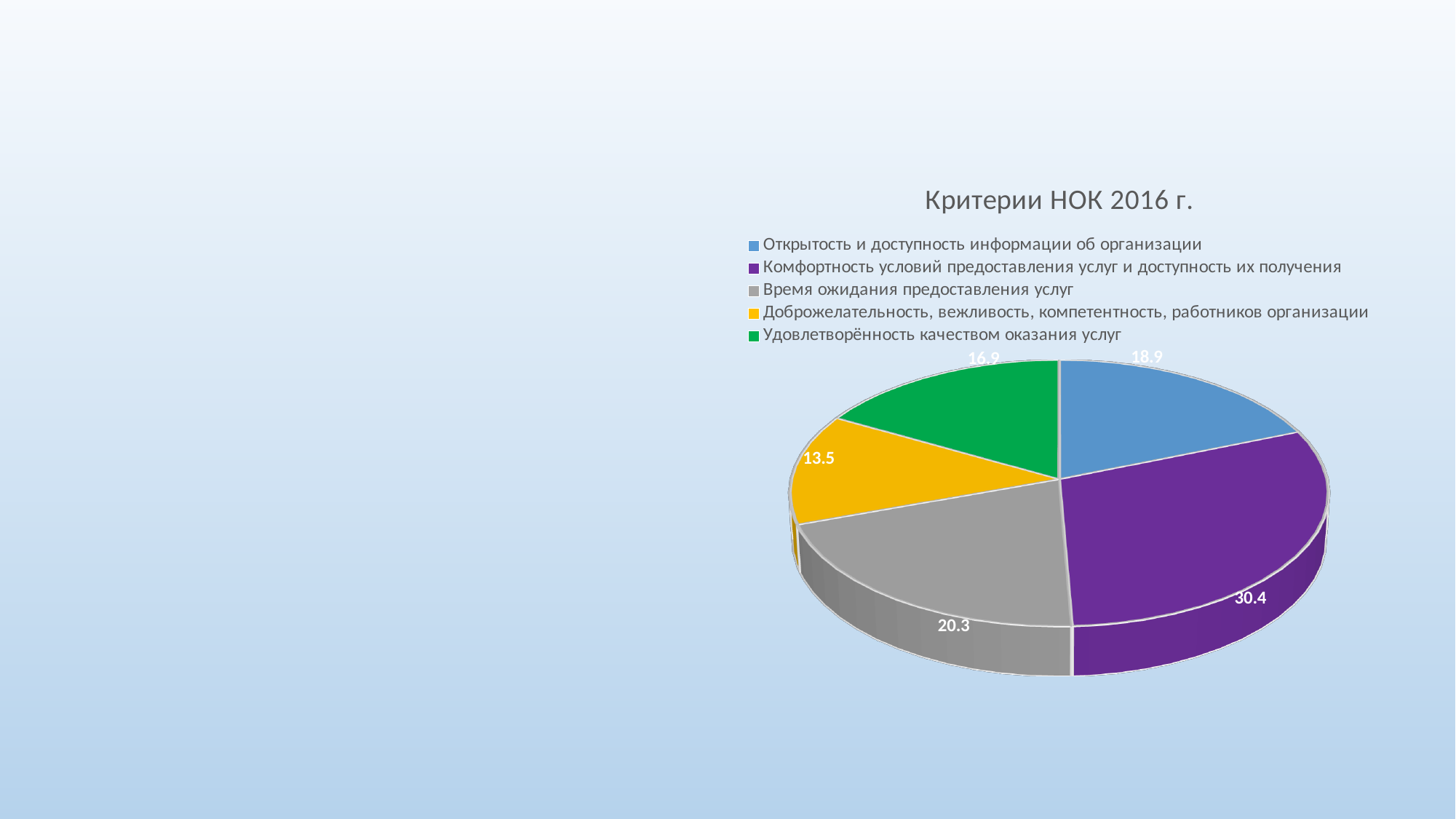
What is the value for "Время ожидания предоставления услуг"? 20.3 Which category has the smallest slice? Доброжелательность, вежливость, компетентность, работников организации What is the title of the chart? Критерии НОК 2016 г. What is the value for "Доброжелательность, вежливость, компетентность, работников организации"? 13.5 What is the value for "Открытость и доступность информации об организации"? 18.9 How many slices does the pie chart have? 5 What kind of chart is shown on the slide? pie chart What is the value for "Удовлетворённость качеством оказания услуг"? 16.9 Which category has the largest slice? Комфортность условий предоставления услуг и доступность их получения What is the value for "Комфортность условий предоставления услуг и доступность их получения"? 30.4 Which is larger: the value for "Открытость и доступность информации об организации" or the value for "Удовлетворённость качеством оказания услуг"? Открытость и доступность информации об организации What is the difference between the values for "Комфортность условий предоставления услуг и доступность их получения" and "Время ожидания предоставления услуг"? 10.1